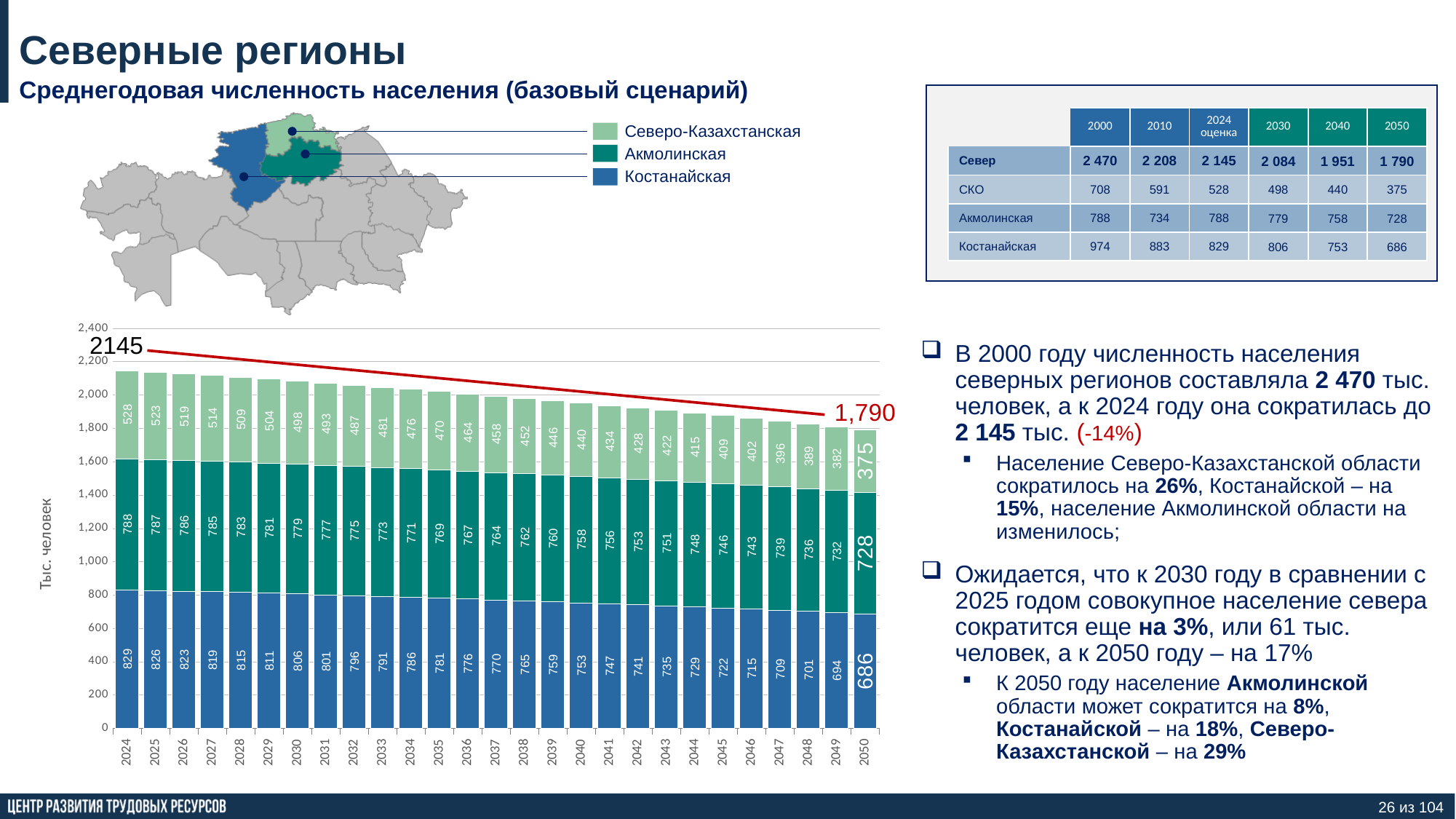
Is the total of the stacked bar for 2040 greater or less than 2,000? less How many series does the legend list? 3 In which year is the Северо-Казахстанская value highest? 2024 What is the total of the stacked bar for 2024? 2145 Do the total bar heights rise or fall from 2024 to 2050? Fall How many years are shown on the x axis of the chart? 27 What is the value for Северо-Казахстанская in 2050? 375 What is the value for Костанайская in 2024? 829 By how much does the Костанайская value fall from 2024 to 2050? 143 In 2030, which is larger: the Акмолинская value or the Костанайская value? Костанайская What is the value for Акмолинская in 2040? 758 What kind of chart is shown on the slide? Stacked bar chart with a line